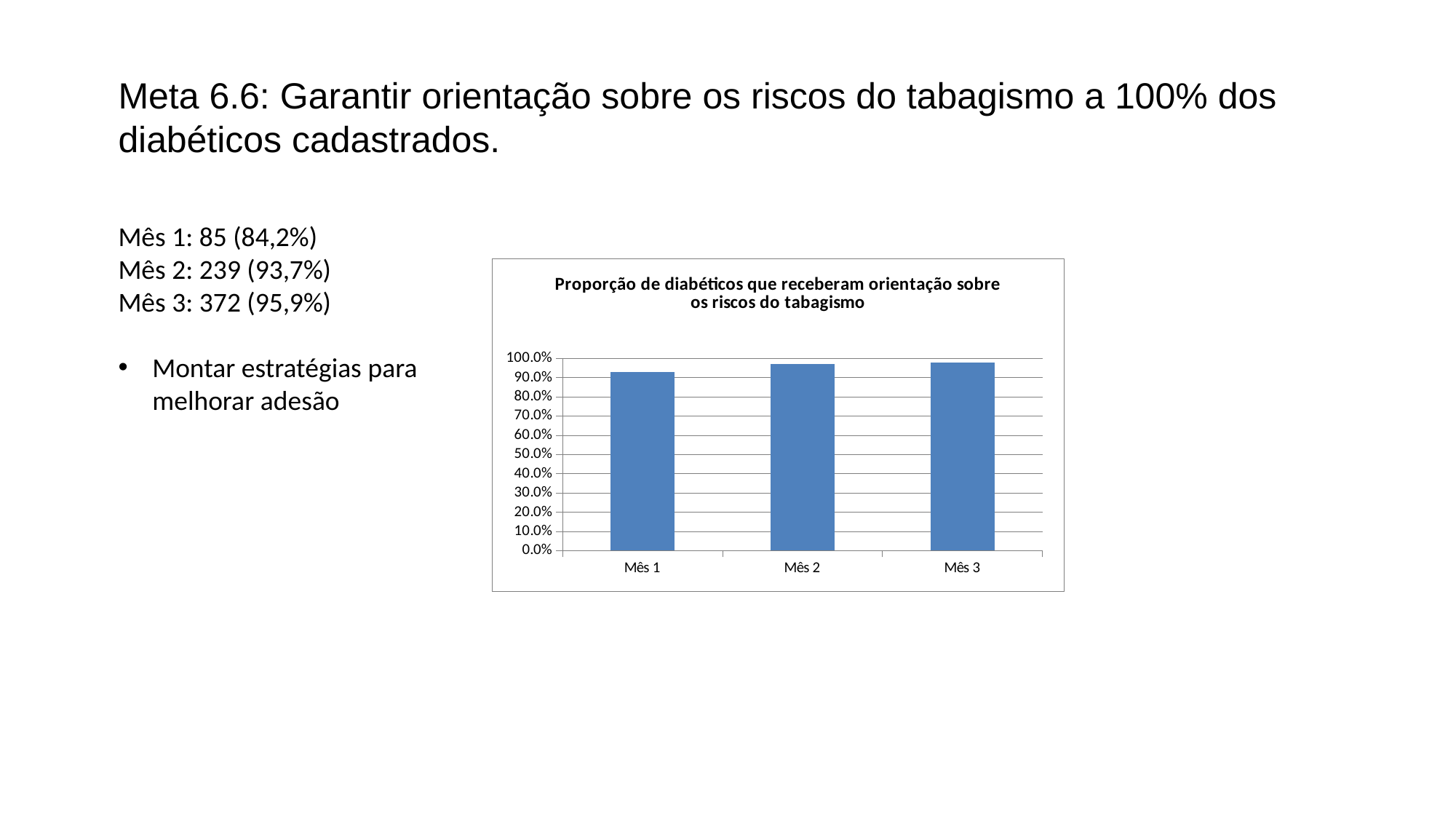
Which bar is taller, Mês 1 or Mês 3? Mês 3 Which month has the lowest bar on the chart? Mês 1 What kind of chart is shown on the slide? bar chart Is the value for Mês 1 greater or less than 100.0%? less Is the value for Mês 1 greater or less than 80.0%? greater Which bar is taller, Mês 1 or Mês 2? Mês 2 How many categories (months) are plotted on the chart? 3 What colour are the bars in the chart? blue Is the value for Mês 2 greater or less than 90.0%? greater What is the title of the chart? Proporção de diabéticos que receberam orientação sobre os riscos do tabagismo Do the bar values rise or fall from Mês 1 to Mês 3? rise